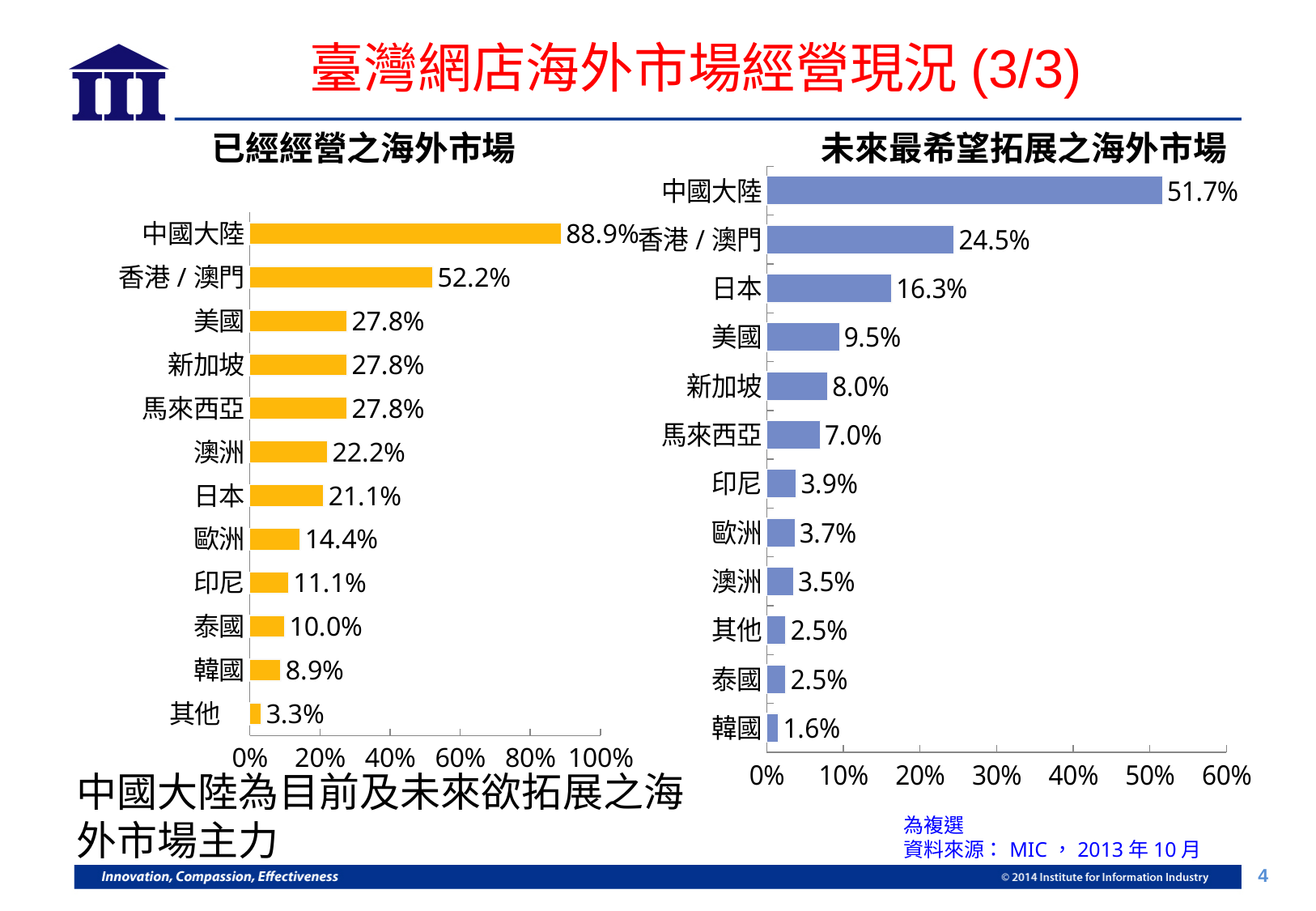
In the chart titled 未來最希望拓展之海外市場, which is larger, the value for 美國 or the value for 新加坡? 美國 How many categories are shown in the chart titled 已經經營之海外市場? 12 In the chart titled 已經經營之海外市場, what is the difference between the values for 中國大陸 and 香港 / 澳門? 36.7% What kind of chart is the chart titled 未來最希望拓展之海外市場? Bar chart In the chart titled 未來最希望拓展之海外市場, what is the value for 日本? 16.3% In the chart titled 已經經營之海外市場, which is larger, the value for 澳洲 or the value for 日本? 澳洲 In the chart titled 未來最希望拓展之海外市場, which category has the lowest value? 韓國 How many categories are shown in the chart titled 未來最希望拓展之海外市場? 12 In the chart titled 已經經營之海外市場, what is the value for 香港 / 澳門? 52.2% In the chart titled 已經經營之海外市場, what is the value for 韓國? 8.9% In the chart titled 已經經營之海外市場, which category has the highest value? 中國大陸 In the chart titled 未來最希望拓展之海外市場, what is the difference between the values for 中國大陸 and 香港 / 澳門? 27.2%